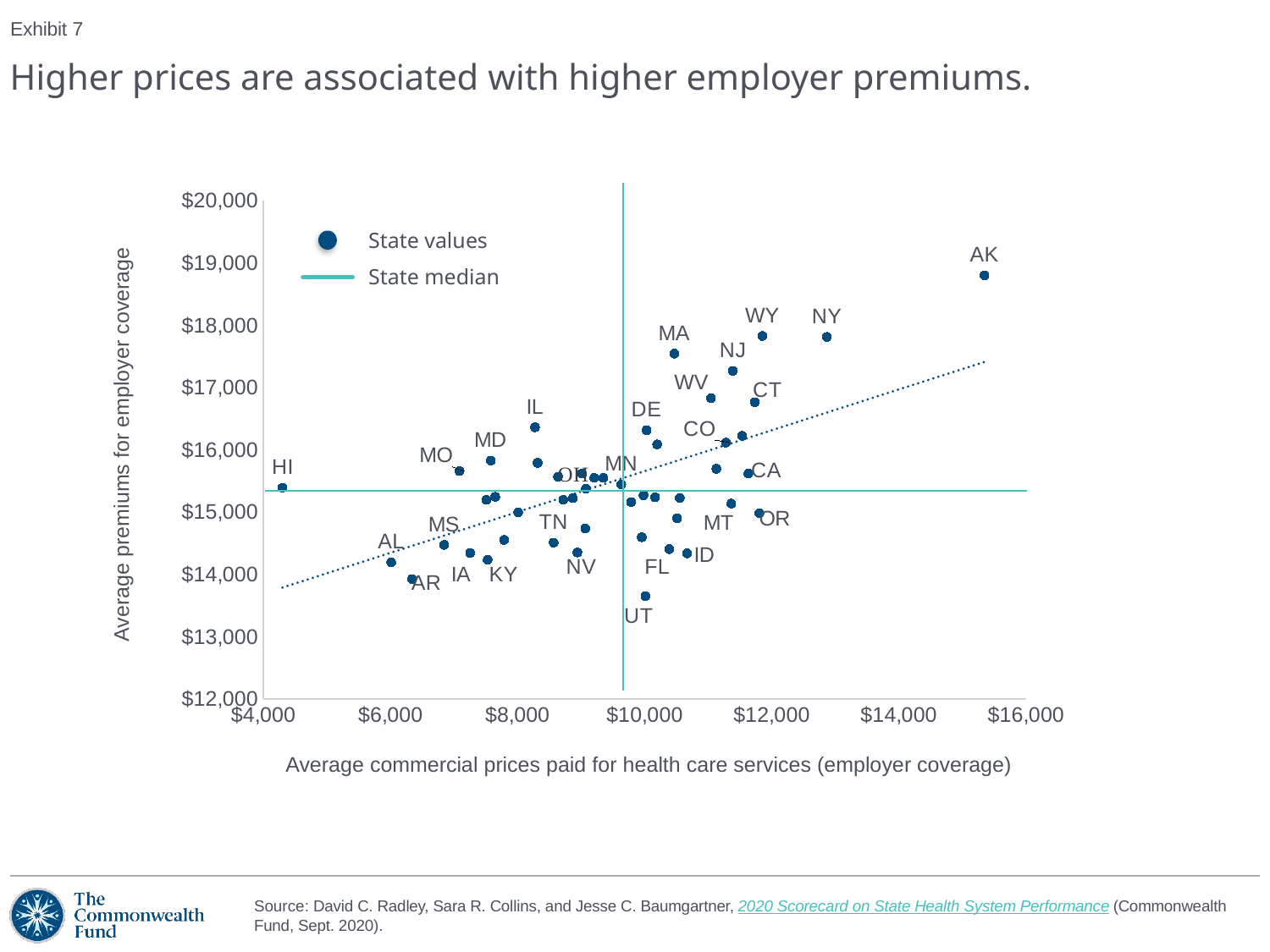
Which state has the higher average commercial price, NY or MA? NY Is the average premium for AK greater or less than $18,000? greater Which state has the highest average premium for employer coverage? AK What kind of chart is shown on the slide? Scatter chart Which state has the lowest average commercial price paid for health care services? HI Is the average commercial price for NY greater or less than $12,000? greater Is the average commercial price for HI greater or less than $6,000? less As average commercial prices increase along the x axis, do average employer premiums generally rise or fall? Rise How many entries does the legend list? 2 Which state has the lowest average premium for employer coverage? UT